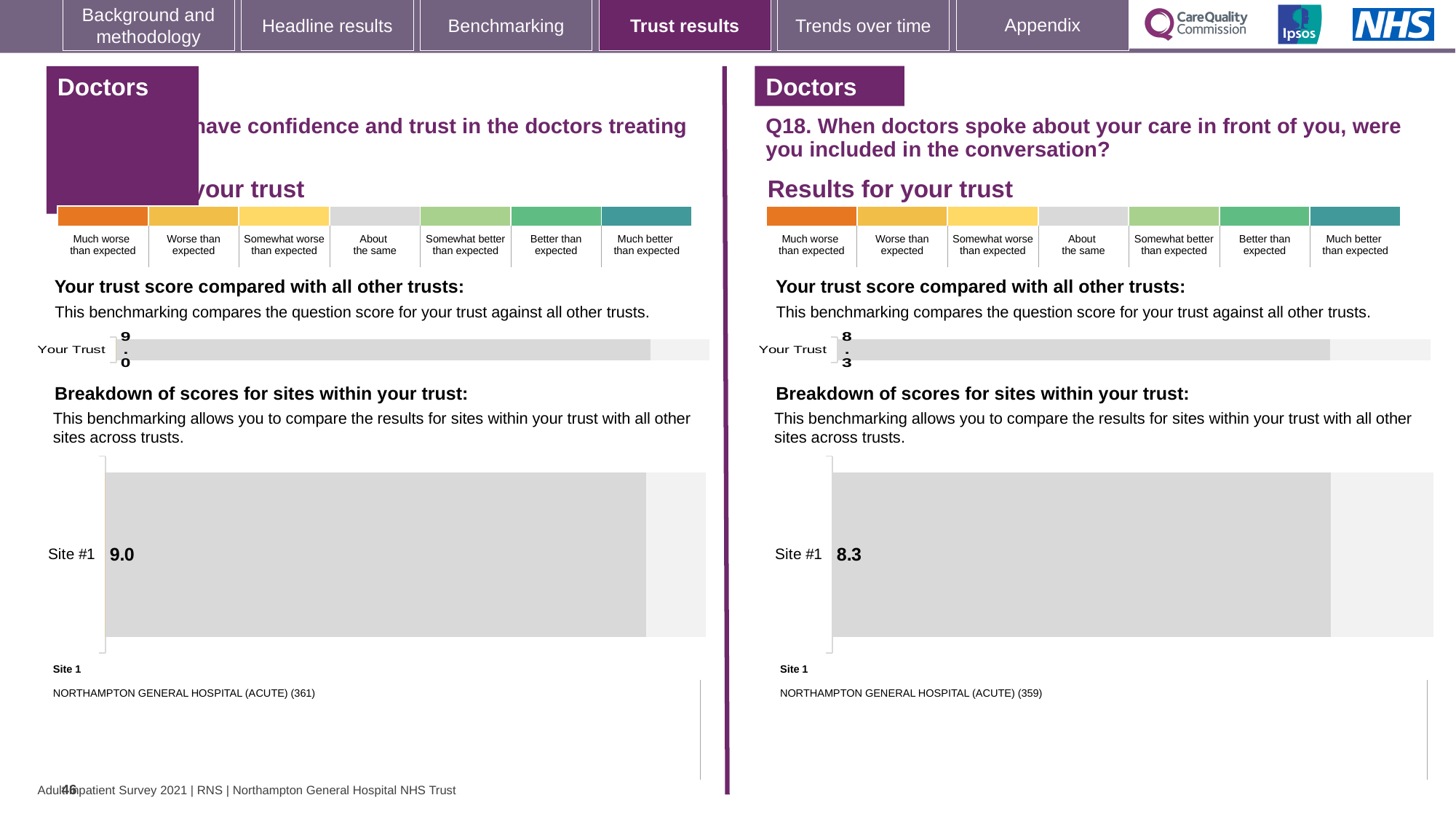
In the right panel (Q18), what is the score for Site #1 in the 'Breakdown of scores for sites within your trust' chart? 8.3 How many sites are shown in the 'Breakdown of scores for sites within your trust' chart in the right panel (Q18)? 1 In the left panel, which hospital is listed as Site 1? NORTHAMPTON GENERAL HOSPITAL (ACUTE) (361) In the left panel's 'Breakdown of scores for sites within your trust' chart, what is the score for Site #1? 9.0 In the right panel (Q18), what is the score for Your Trust in the 'Your trust score compared with all other trusts' chart? 8.3 How many bars are shown in the 'Your trust score compared with all other trusts' chart in the left panel? 1 What kind of chart is used to show the Site #1 score in the left panel? bar chart In the right panel (Q18), is the Site #1 score greater than, less than, or equal to the Your Trust score? equal In the right panel (Q18), which hospital is listed as Site 1? NORTHAMPTON GENERAL HOSPITAL (ACUTE) (359) In the left panel's 'Your trust score compared with all other trusts' chart, what is the score for Your Trust? 9.0 Which panel shows the higher Your Trust score, the left panel or the right panel (Q18)? left panel What is the difference between the Your Trust score in the left panel and the Your Trust score in the right panel (Q18)? 0.7